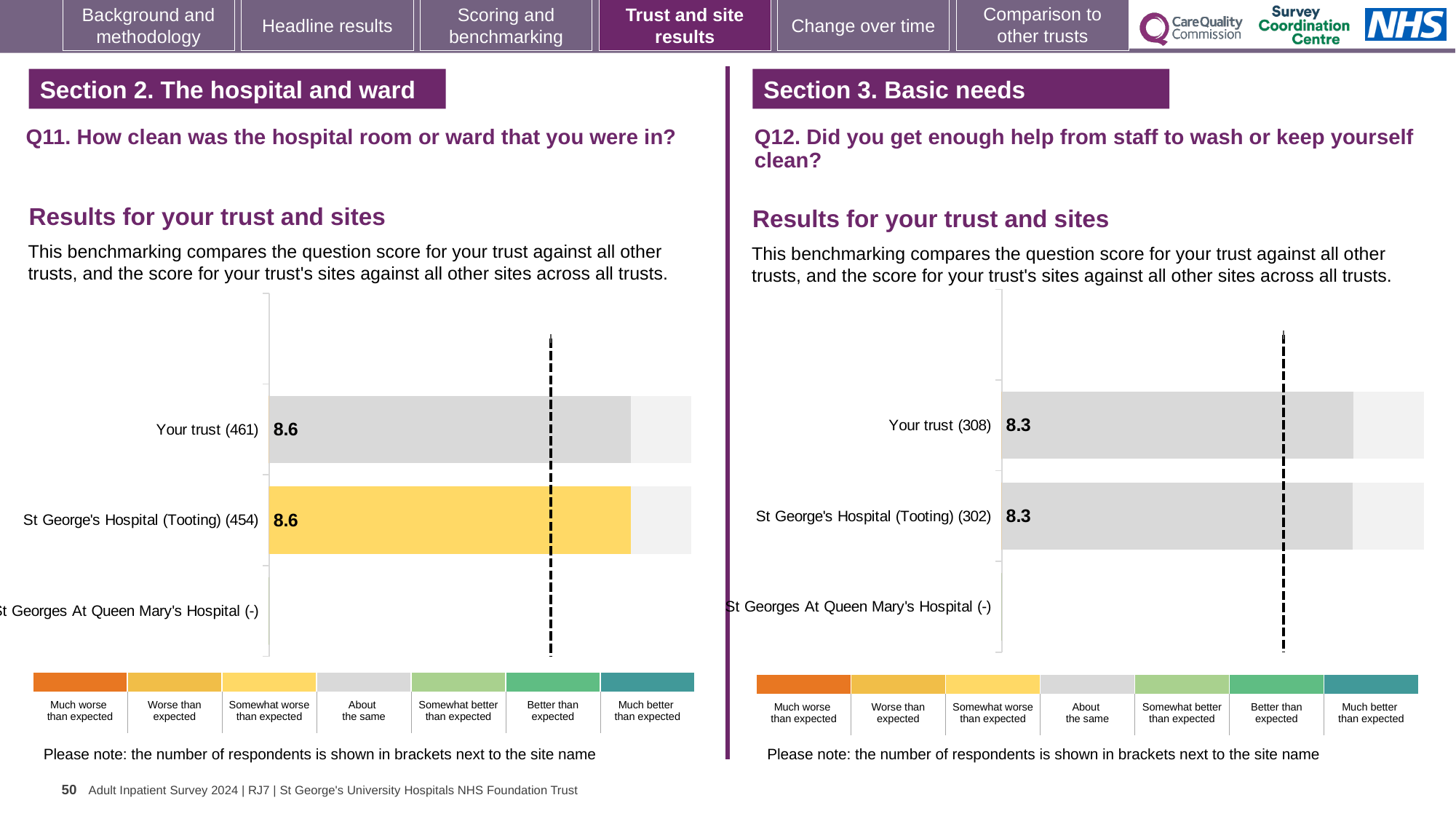
In the Q12 chart (right), what is the score for Your trust? 8.3 In the Q12 chart (right), what is the score for St George's Hospital (Tooting)? 8.3 In the Q11 chart (left), what is the score for St George's Hospital (Tooting)? 8.6 In the Q11 chart (left), which benchmark category does the yellow colour of the St George's Hospital (Tooting) bar represent according to the legend? Somewhat worse than expected How many site/trust categories are listed on the Q11 chart (left)? 3 In the Q12 chart (right), what is the difference between the score for Your trust and the score for St George's Hospital (Tooting)? 0 In the Q11 chart (left), what is the score for Your trust? 8.6 In the Q12 chart (right), how many respondents are shown in brackets for Your trust? 308 In the Q11 chart (left), what is the difference between the score for Your trust and the score for St George's Hospital (Tooting)? 0 What kind of chart is used for the Q11 results (left)? Bar chart In the Q11 chart (left), how many respondents are shown in brackets for St George's Hospital (Tooting)? 454 How many site/trust categories are listed on the Q12 chart (right)? 3